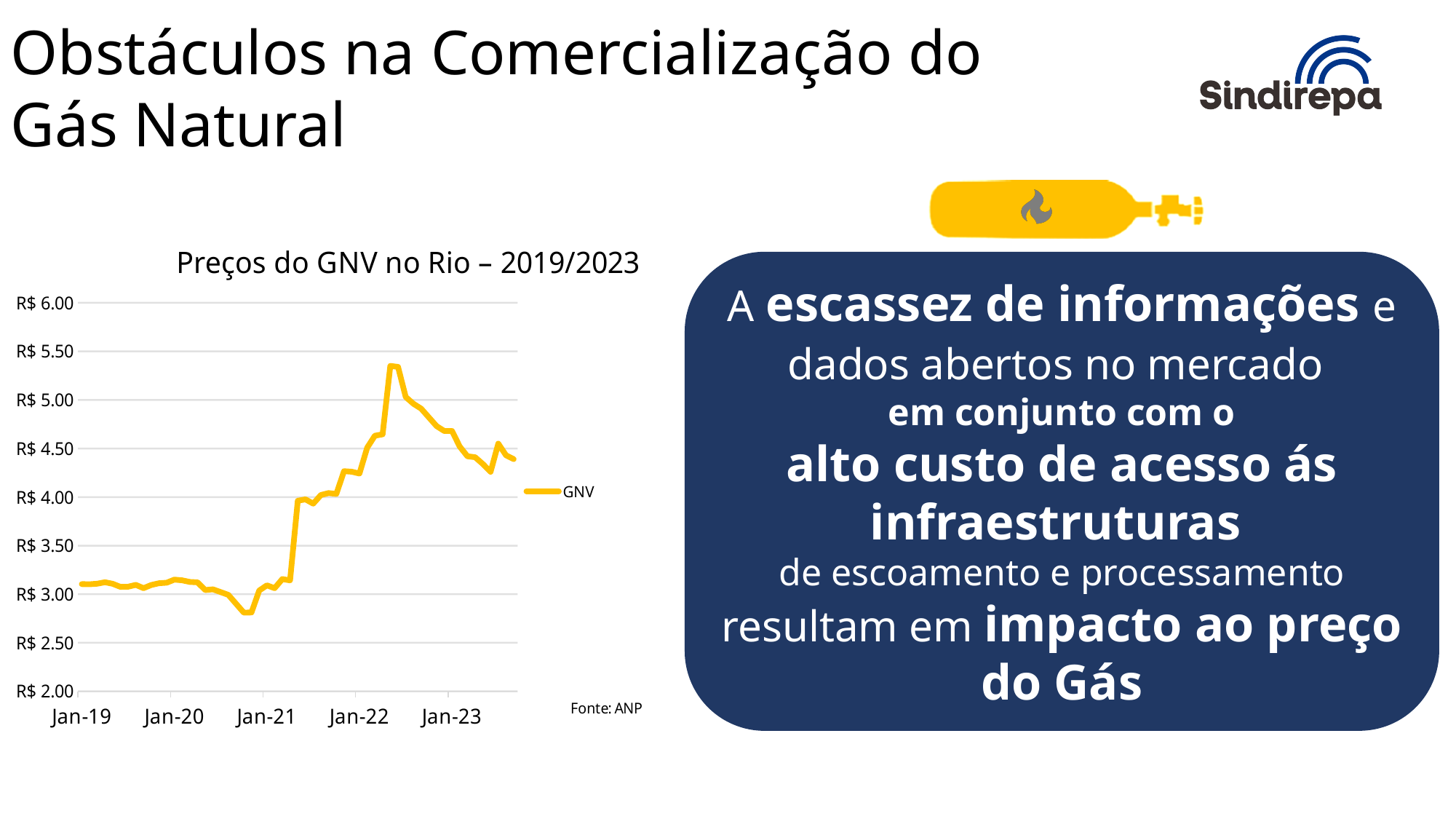
Is the GNV price at Jan-19 greater or less than R$ 3.50? less What is the title of the chart? Preços do GNV no Rio – 2019/2023 Is the GNV price at Jan-21 greater or less than R$ 3.50? less Is the GNV price at Jan-22 greater or less than R$ 4.00? greater How many series does the chart's legend list? 1 How many year labels are shown on the x axis? 5 What is the name of the series shown in the legend? GNV What kind of chart is shown on the slide? line chart Which is larger, the GNV price at Jan-22 or at Jan-19? Jan-22 Does the GNV price rise or fall between Jan-21 and Jan-22? rise